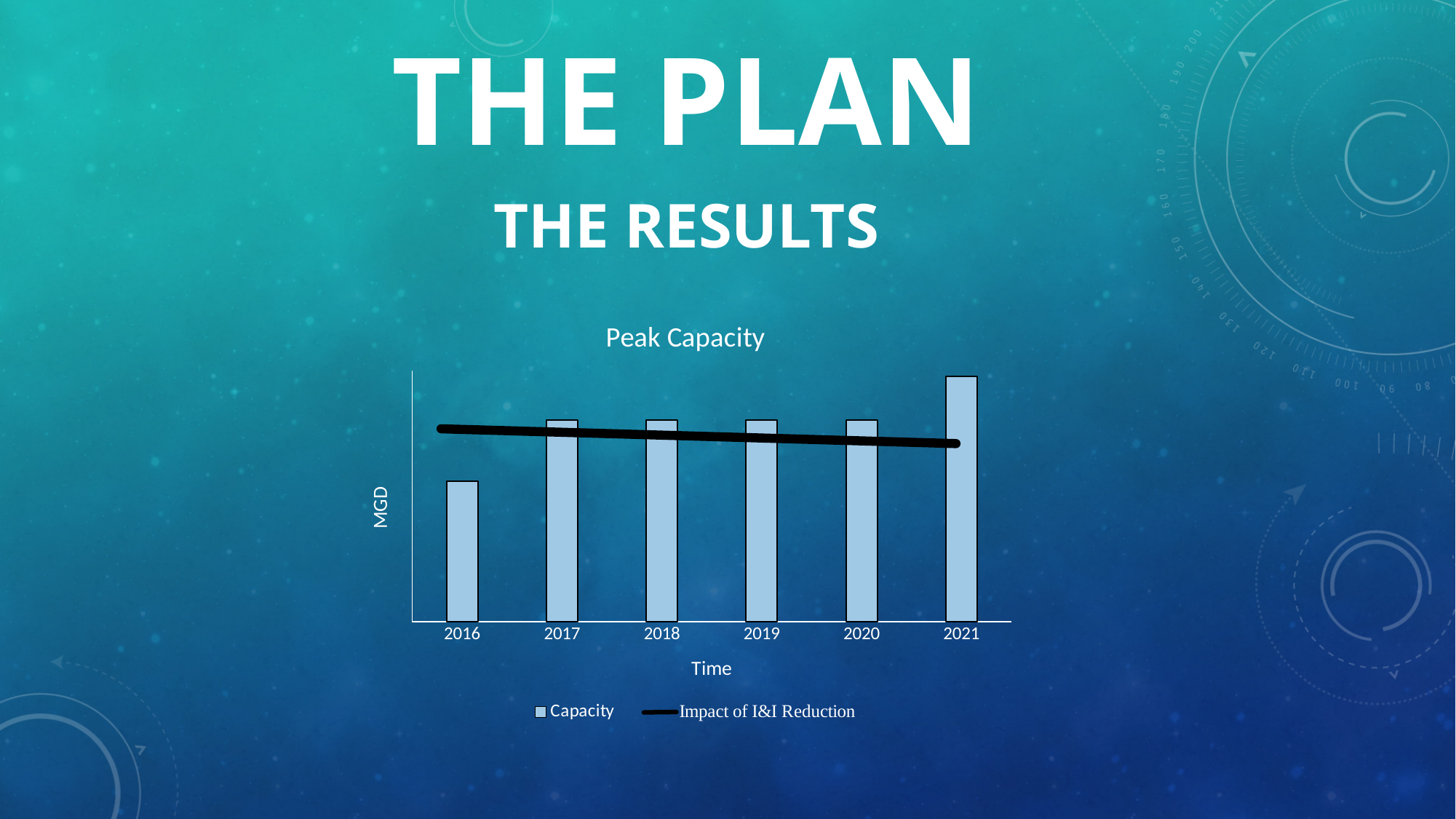
How many series does the chart legend list? 2 Does the Capacity bar increase or decrease from 2016 to 2017? increase How many years are shown on the x axis of the chart? 6 What is the name of the series drawn as a line in the chart? Impact of I&I Reduction Which year has the lowest Capacity bar? 2016 What label is shown on the y axis of the chart? MGD Which is larger, the Capacity bar for 2017 or the Capacity bar for 2016? 2017 What type of chart is used to show the Capacity series? bar chart What is the title of the chart? Peak Capacity Which year has the highest Capacity bar? 2021 Does the Impact of I&I Reduction line rise or fall from 2016 to 2021? fall Is the Capacity bar for 2021 larger or smaller than the Capacity bar for 2016? larger